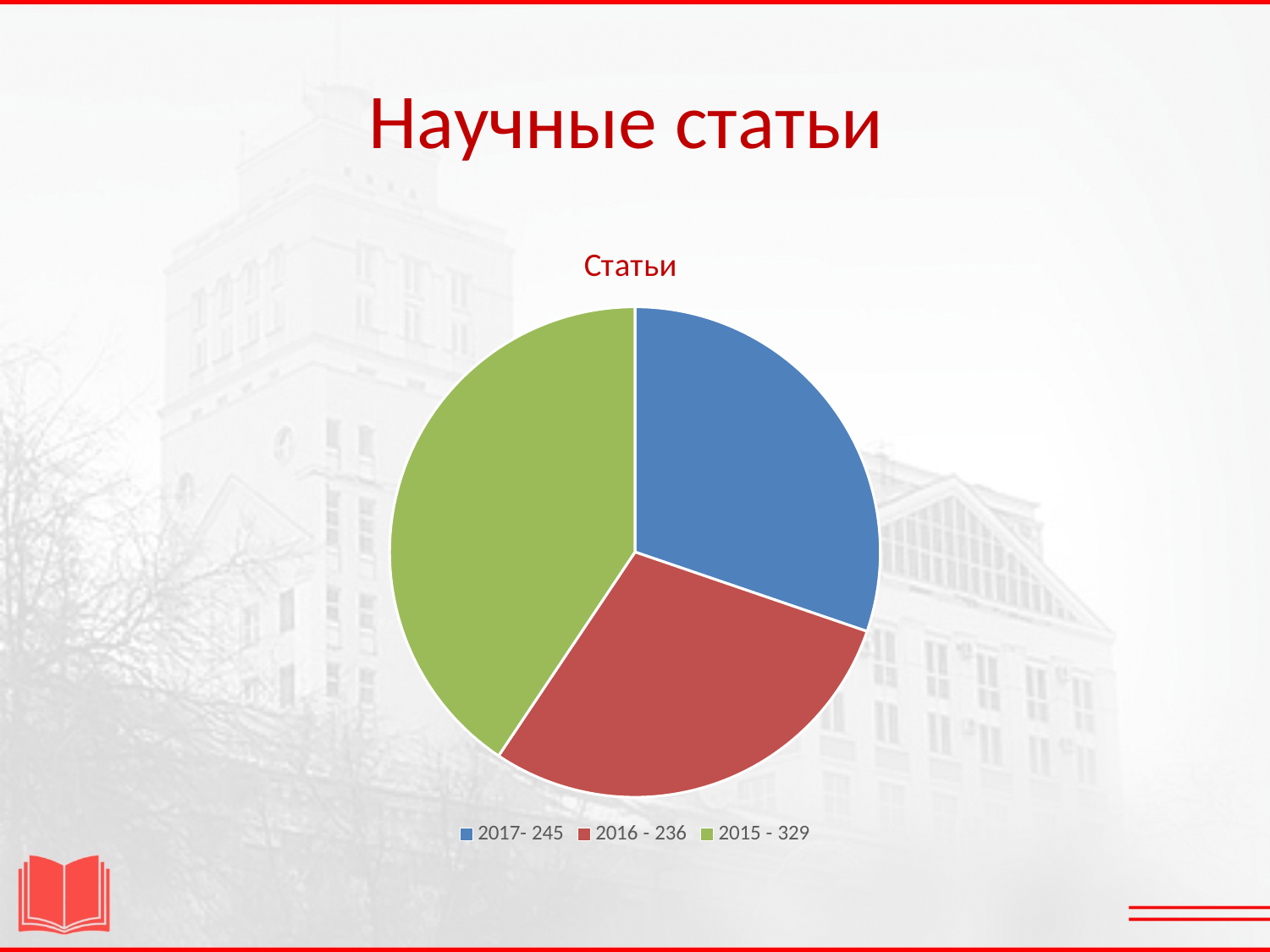
What colour is the slice for 2015? green What is the value for 2016? 236 What is the difference between the values for 2015 and 2017? 84 Which year has the largest value? 2015 How many entries does the legend list? 3 Which is larger, the value for 2017 or the value for 2016? 2017 What is the title of the chart? Статьи What type of chart is shown on the slide? pie chart What is the value for 2017? 245 What is the value for 2015? 329 How many slices does the pie chart have? 3 Which year has the smallest value? 2016